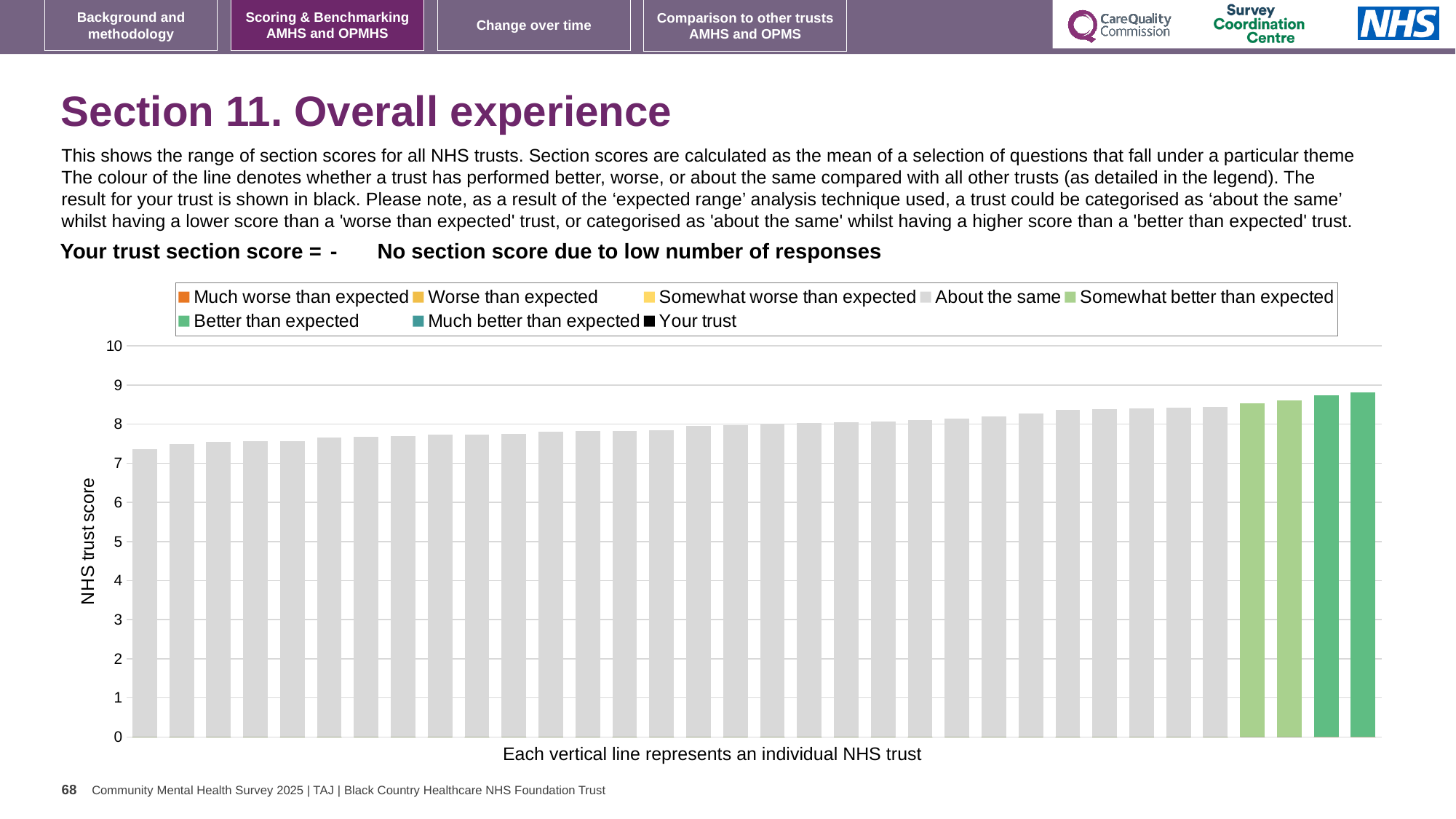
Is the value of the leftmost bar greater or less than 8? less How many bars are coloured in the 'Somewhat better than expected' light green? 2 How many bars are coloured in the 'Better than expected' green? 2 Is the value of the leftmost bar greater or less than 7? greater Is the value of the rightmost bar greater or less than 8? greater Which bar has the highest value, the leftmost or the rightmost? Rightmost How many entries does the chart legend list? 8 What is the label on the vertical axis of the chart? NHS trust score What is the trust's section score shown above the chart? No section score due to low number of responses Do the bar values rise or fall from left to right along the x axis? Rise What kind of chart is shown on the slide? Bar chart